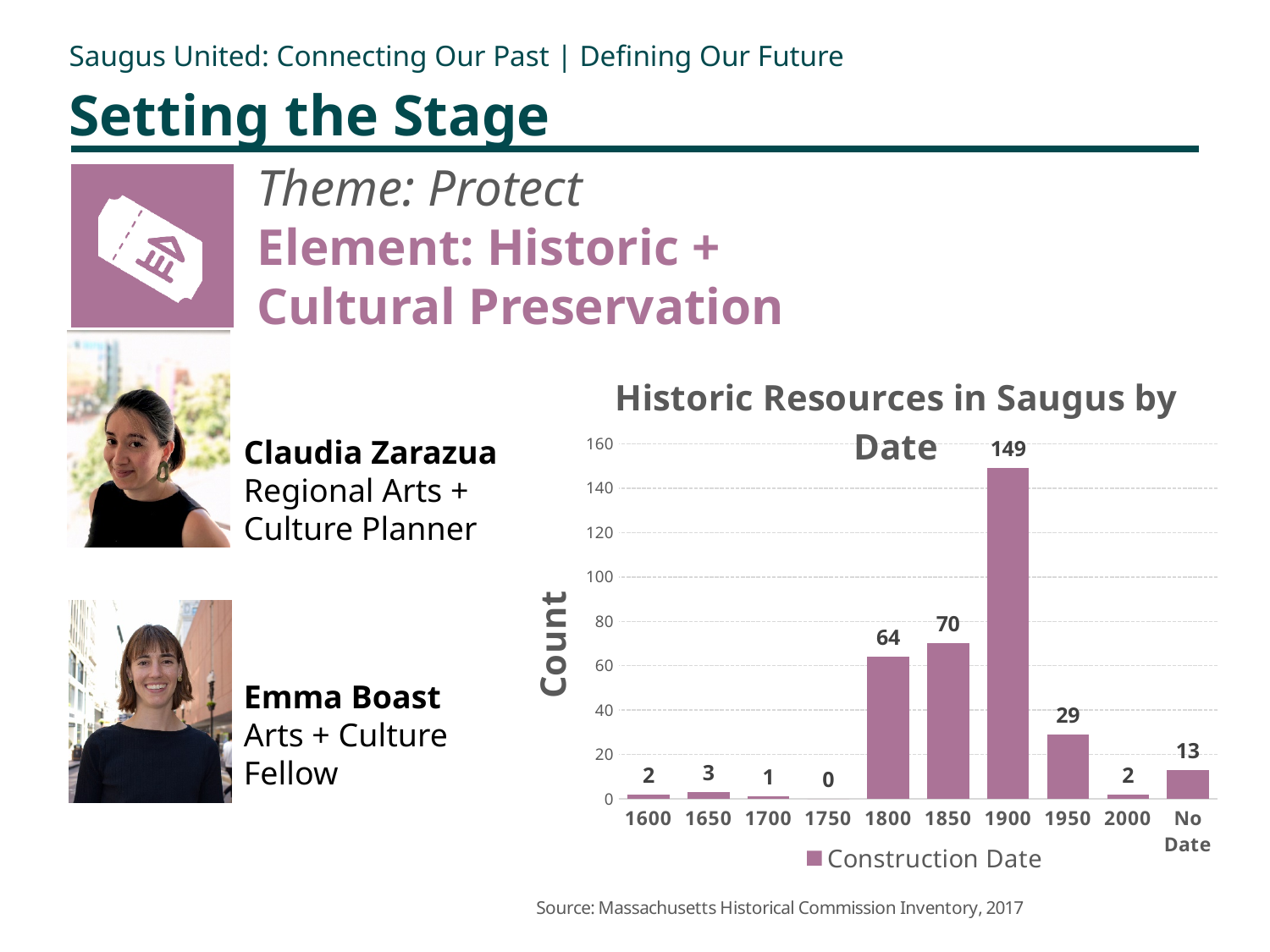
Which construction date category has the lowest count? 1750 Which construction date category has the highest count? 1900 What is the difference between the counts for 1900 and 1850? 79 Which has a higher count, 1850 or 1950? 1850 How many series does the legend list? 1 What is the title of the chart? Historic Resources in Saugus by Date What is the count of historic resources for the 1900 construction date? 149 What kind of chart is shown on the slide? Bar chart What is the count of historic resources for the 1800 construction date? 64 What is the count of historic resources with No Date? 13 What is the label of the y axis? Count How many construction date categories are shown on the x axis? 10